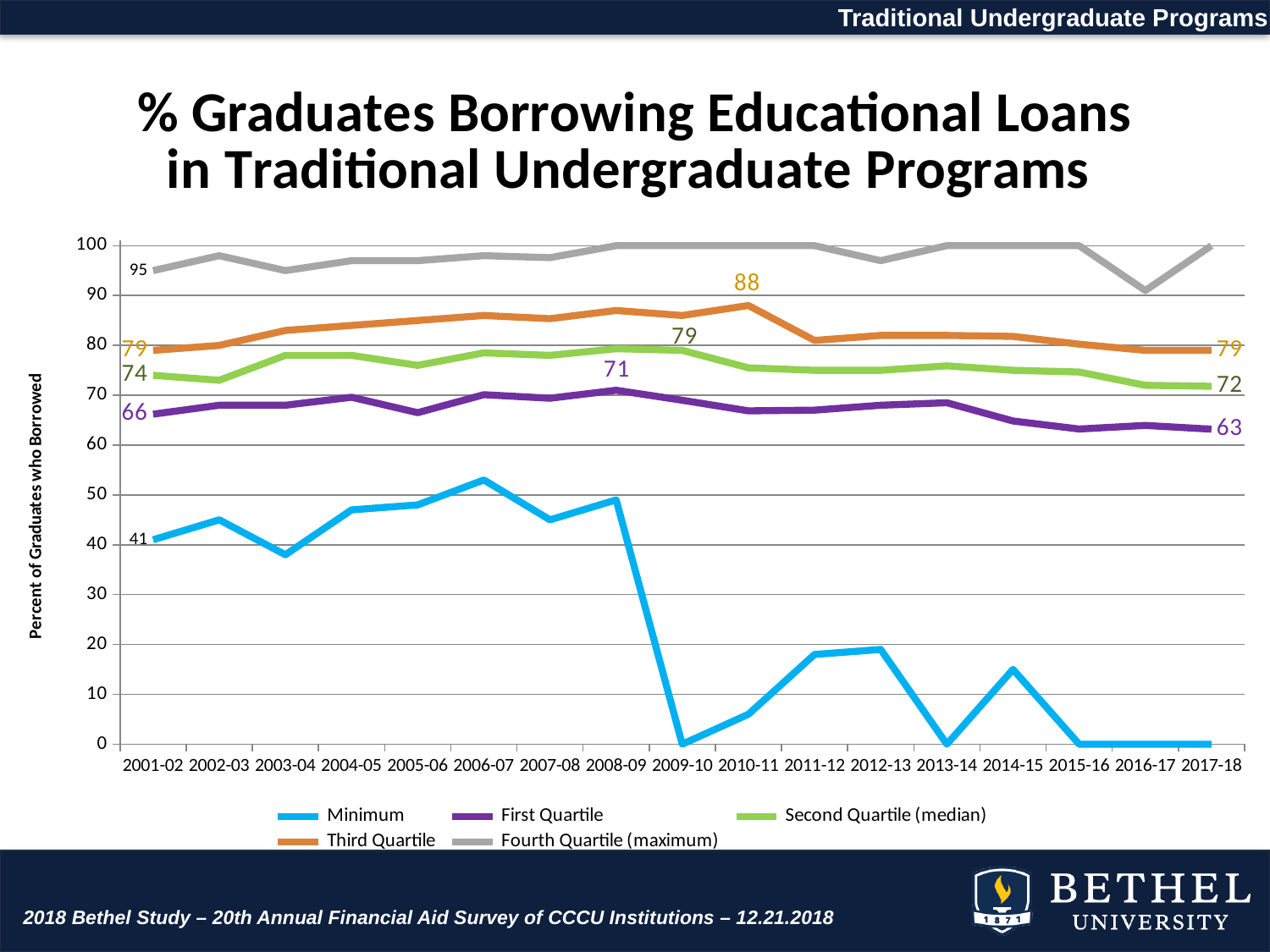
What is the difference between the First Quartile value in 2001-02 and in 2017-18? 3 How many series does the legend list? 5 What kind of chart is shown on the slide? line chart What colour is the Minimum line in the legend? light blue What is the First Quartile value for 2017-18? 63 Does the Minimum line rise or fall from 2008-09 to 2009-10? fall Which is larger, the Second Quartile (median) value in 2001-02 or in 2017-18? 2001-02 How many academic years are shown along the x axis? 17 What is the Third Quartile value for 2010-11? 88 Is the Minimum value for 2006-07 greater or less than 50? greater What is the Minimum value for 2001-02? 41 What is the Fourth Quartile (maximum) value for 2001-02? 95